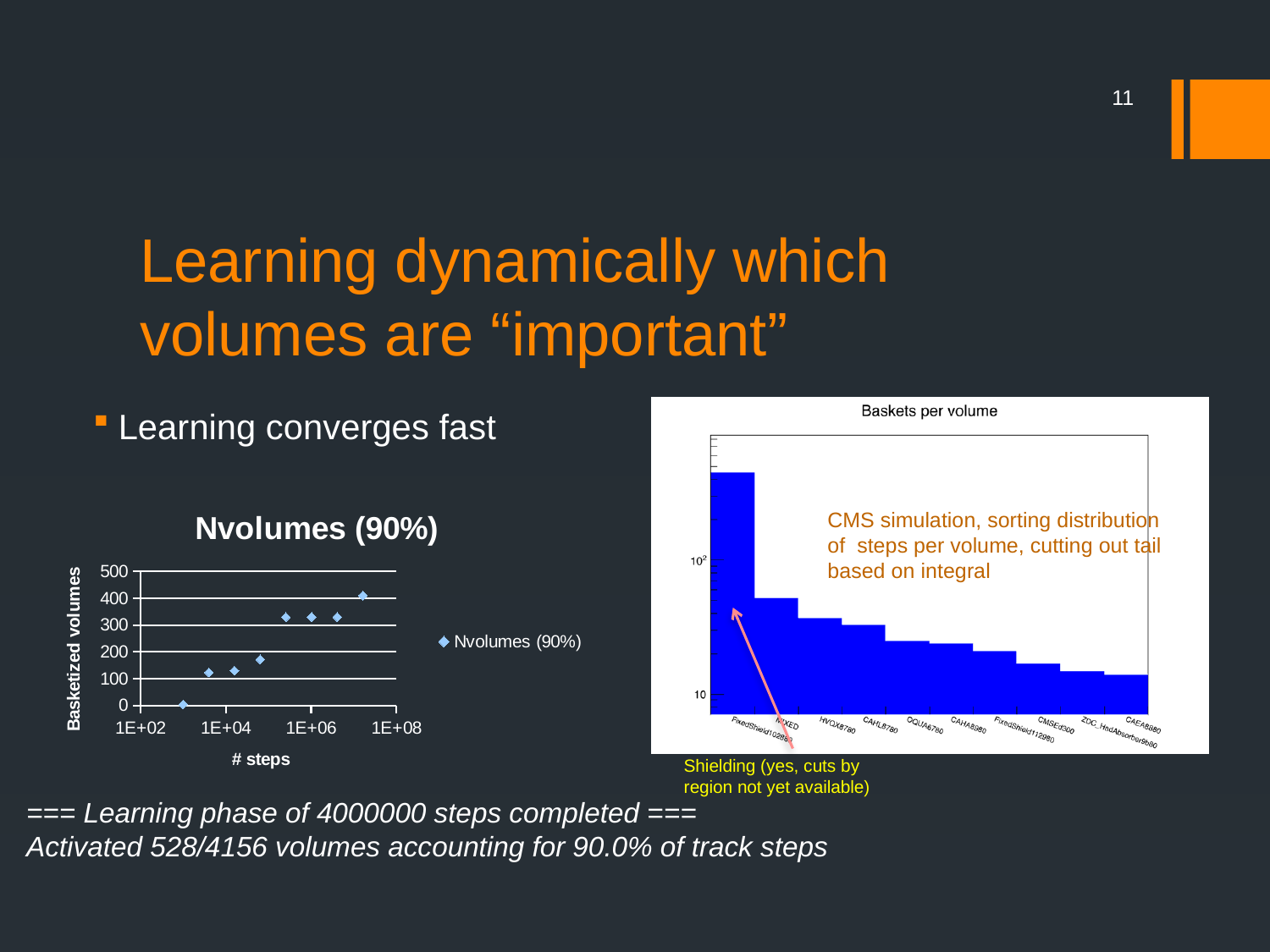
How many data points are plotted in the "Nvolumes (90%)" chart? 8 In the "Nvolumes (90%)" chart, do the values generally rise or fall as the number of steps increases? rise In the "Nvolumes (90%)" chart, is the value of the point near 1E+04 steps greater or less than 200? less What is the x-axis title of the "Nvolumes (90%)" chart? # steps In the "Nvolumes (90%)" chart, is the value of the rightmost point (near 1E+08 steps) greater or less than 300? greater In the "Baskets per volume" chart, which volume has the lowest bar? CAEA8980 (the rightmost bar) What kind of chart is the "Baskets per volume" chart on the right of the slide? bar chart What is the y-axis title of the "Nvolumes (90%)" chart? Basketized volumes What kind of chart is the "Nvolumes (90%)" chart on the left of the slide? scatter chart How many series does the legend of the "Nvolumes (90%)" chart list? 1 In the "Baskets per volume" chart, do the bar heights rise or fall from left to right? fall